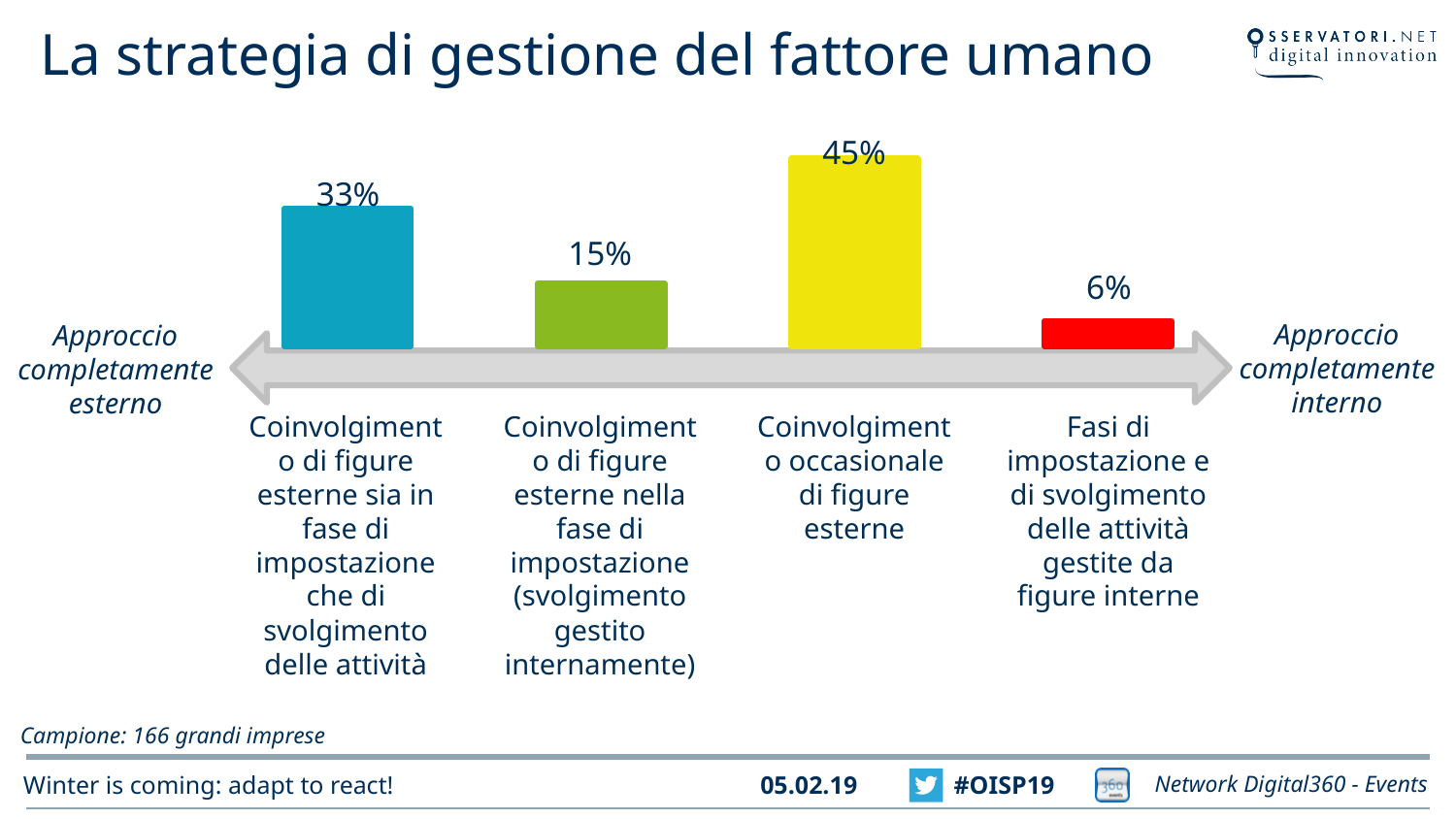
What is the value for 'Coinvolgimento di figure esterne sia in fase di impostazione che di svolgimento delle attività'? 33% What is the difference between the values for 'Coinvolgimento di figure esterne nella fase di impostazione (svolgimento gestito internamente)' and 'Fasi di impostazione e di svolgimento delle attività gestite da figure interne'? 9% What is the value for 'Fasi di impostazione e di svolgimento delle attività gestite da figure interne'? 6% What is the title of the slide containing the chart? La strategia di gestione del fattore umano Which category has the lowest value? Fasi di impostazione e di svolgimento delle attività gestite da figure interne What is the value for 'Coinvolgimento occasionale di figure esterne'? 45% Which category has the highest value? Coinvolgimento occasionale di figure esterne How many categories are shown in the chart? 4 What is the difference between the values for 'Coinvolgimento occasionale di figure esterne' and 'Coinvolgimento di figure esterne sia in fase di impostazione che di svolgimento delle attività'? 12% Which is larger: the value for 'Coinvolgimento di figure esterne sia in fase di impostazione che di svolgimento delle attività' or the value for 'Coinvolgimento di figure esterne nella fase di impostazione (svolgimento gestito internamente)'? Coinvolgimento di figure esterne sia in fase di impostazione che di svolgimento delle attività What is the value for 'Coinvolgimento di figure esterne nella fase di impostazione (svolgimento gestito internamente)'? 15% What kind of chart is shown on the slide? Bar chart